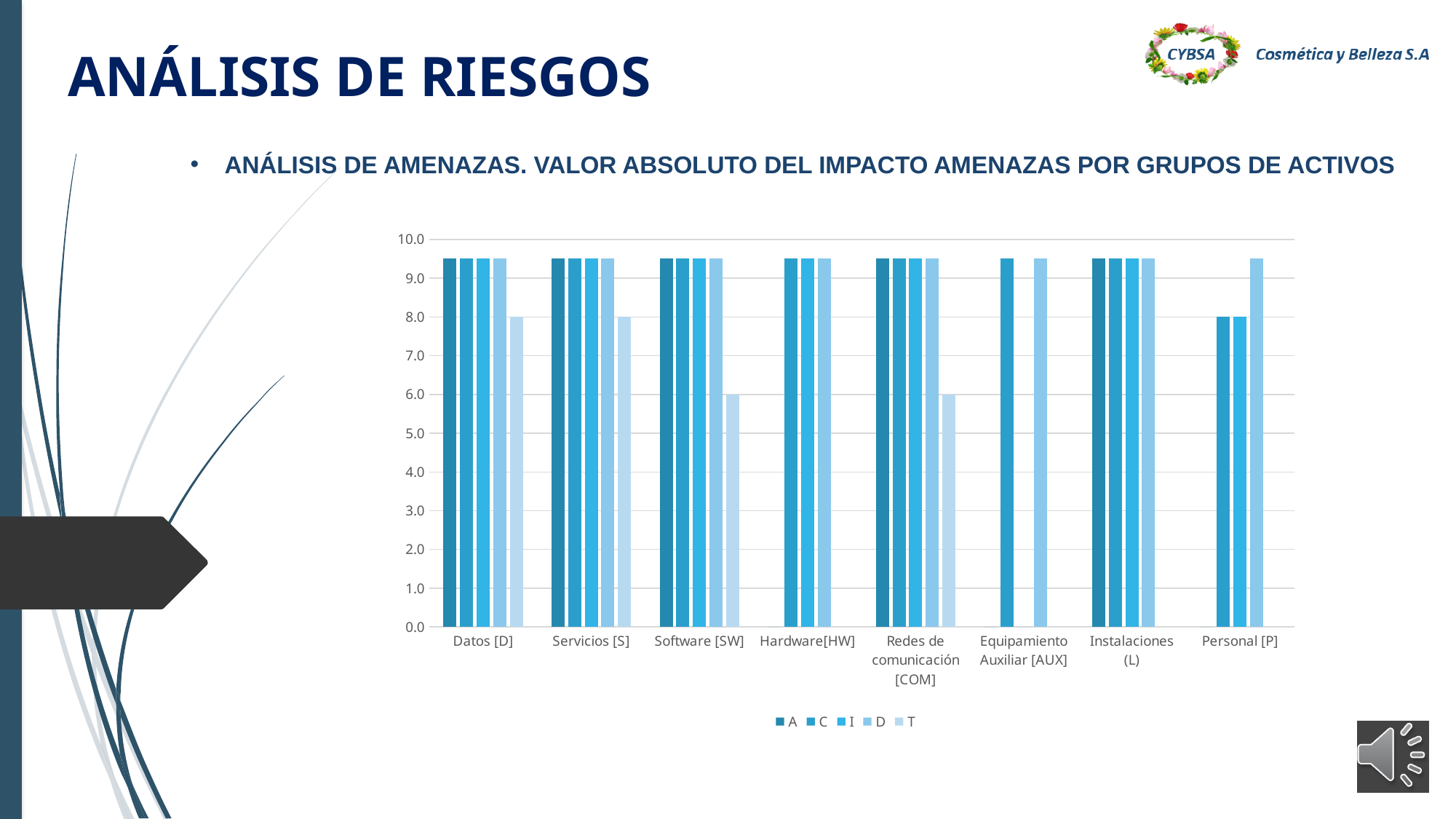
What is the value of series T for Datos [D]? 8.0 Is the value of series A for Datos [D] greater or less than 9.0? greater How many asset group categories are shown on the x axis? 8 What are the series names listed in the legend? A, C, I, D, T How many series does the legend list? 5 What is the value of series T for Redes de comunicación [COM]? 6.0 Which is larger: the value of series T for Servicios [S] or the value of series T for Software [SW]? Servicios [S] What kind of chart is shown on the slide? bar chart What is the value of series T for Software [SW]? 6.0 For Personal [P], which series has the highest value? D